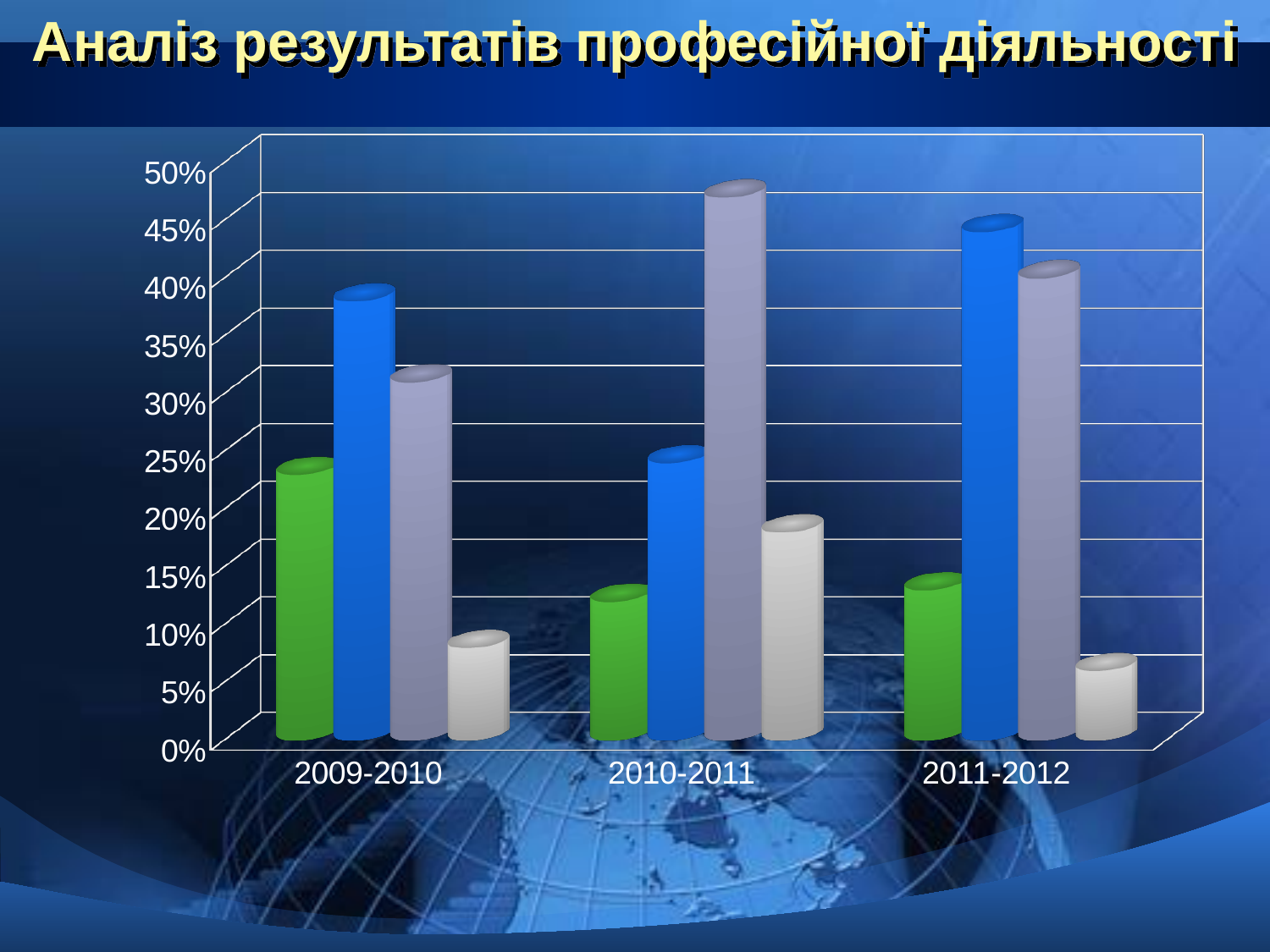
Which bar is the lowest in the 2009-2010 group? The white bar Is the value of the blue bar for 2009-2010 greater or less than 35%? greater Is the value of the grey bar for 2010-2011 greater or less than 45%? greater What is the highest value shown on the vertical axis? 50% What is the title of the slide containing the chart? Аналіз результатів професійної діяльності In 2010-2011, which bar is taller: the grey bar or the blue bar? The grey bar Is the value of the white bar for 2009-2010 greater or less than 10%? less Which academic year contains the tallest bar in the chart? 2010-2011 How many bars are plotted for each academic year? 4 How many categories (academic years) are shown on the x axis? 3 What kind of chart is shown on the slide? Bar chart